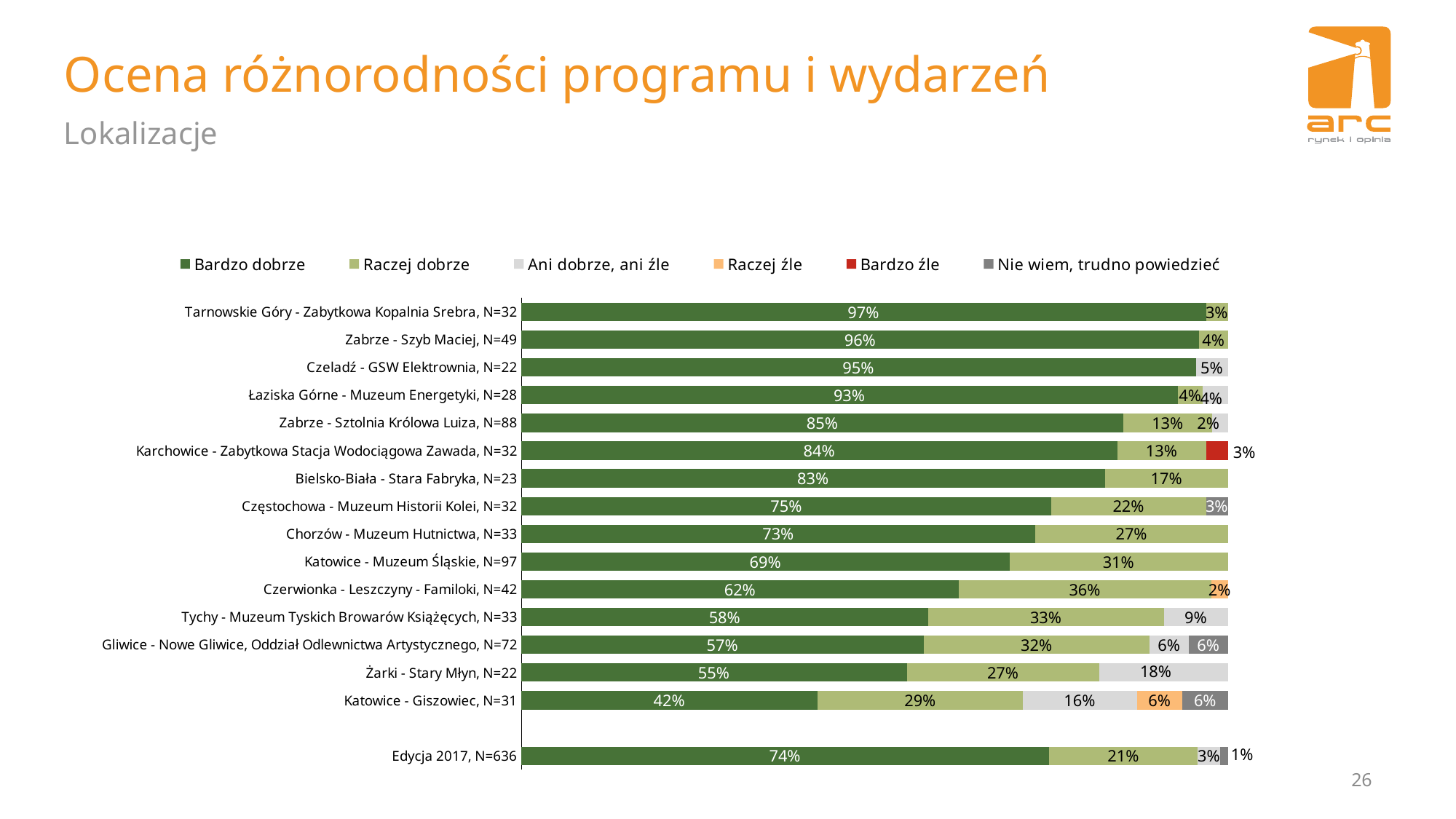
What type of chart is shown on the slide? Stacked bar chart What is the "Ani dobrze, ani źle" share for Żarki - Stary Młyn? 18% How many series does the legend list? 6 What is the "Bardzo dobrze" value for Edycja 2017, N=636? 74% What is the "Raczej dobrze" value for Czerwionka - Leszczyny - Familoki? 36% Which location has the highest "Bardzo dobrze" share? Tarnowskie Góry - Zabytkowa Kopalnia Srebra What is the difference in "Bardzo dobrze" share between Tarnowskie Góry - Zabytkowa Kopalnia Srebra and Katowice - Giszowiec? 55 percentage points How many bars are shown in the chart, including Edycja 2017? 16 Which location has the lowest "Bardzo dobrze" share? Katowice - Giszowiec What is the "Bardzo źle" value shown for Karchowice - Zabytkowa Stacja Wodociągowa Zawada? 3% Which has a larger "Bardzo dobrze" share: Chorzów - Muzeum Hutnictwa or Częstochowa - Muzeum Historii Kolei? Częstochowa - Muzeum Historii Kolei What percentage of respondents rated Katowice - Muzeum Śląskie as "Bardzo dobrze"? 69%